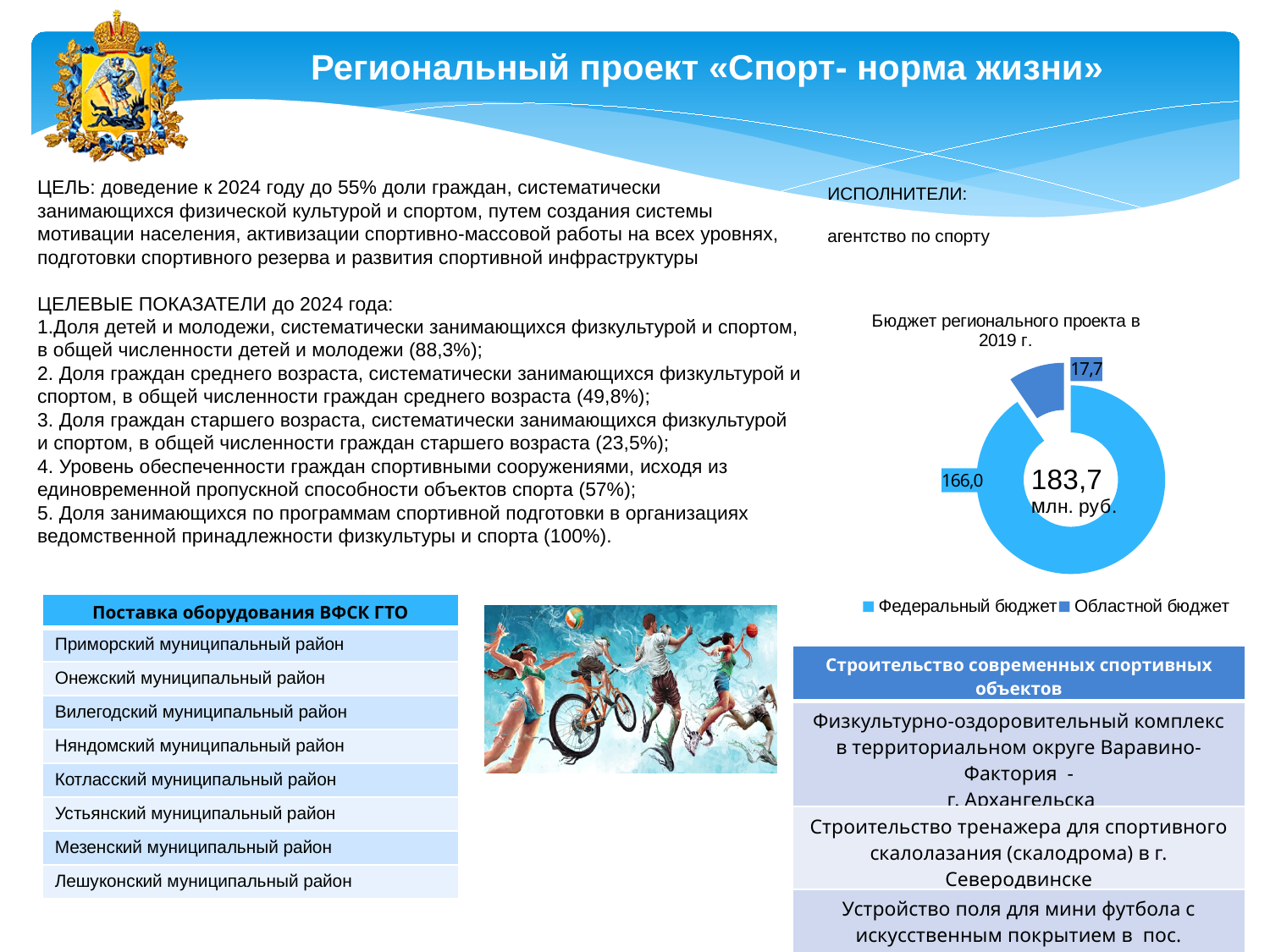
In the chart 'Бюджет регионального проекта в 2019 г.', which is larger: Федеральный бюджет or Областной бюджет? Федеральный бюджет What is the value for Областной бюджет in the chart 'Бюджет регионального проекта в 2019 г.'? 17,7 What is the value for Федеральный бюджет in the chart 'Бюджет регионального проекта в 2019 г.'? 166,0 Which budget source has the largest slice in the chart 'Бюджет регионального проекта в 2019 г.'? Федеральный бюджет What total is shown in the centre of the chart 'Бюджет регионального проекта в 2019 г.'? 183,7 млн. руб. How many entries does the legend of the chart 'Бюджет регионального проекта в 2019 г.' list? 2 How many slices does the chart 'Бюджет регионального проекта в 2019 г.' have? 2 Which legend entry in the chart 'Бюджет регионального проекта в 2019 г.' is shown in the darker blue colour? Областной бюджет What is the difference between the Федеральный бюджет and Областной бюджет values in the chart 'Бюджет регионального проекта в 2019 г.'? 148,3 What is the title of the doughnut chart on the slide? Бюджет регионального проекта в 2019 г. Which budget source has the smallest slice in the chart 'Бюджет регионального проекта в 2019 г.'? Областной бюджет What kind of chart is 'Бюджет регионального проекта в 2019 г.'? Doughnut (pie) chart